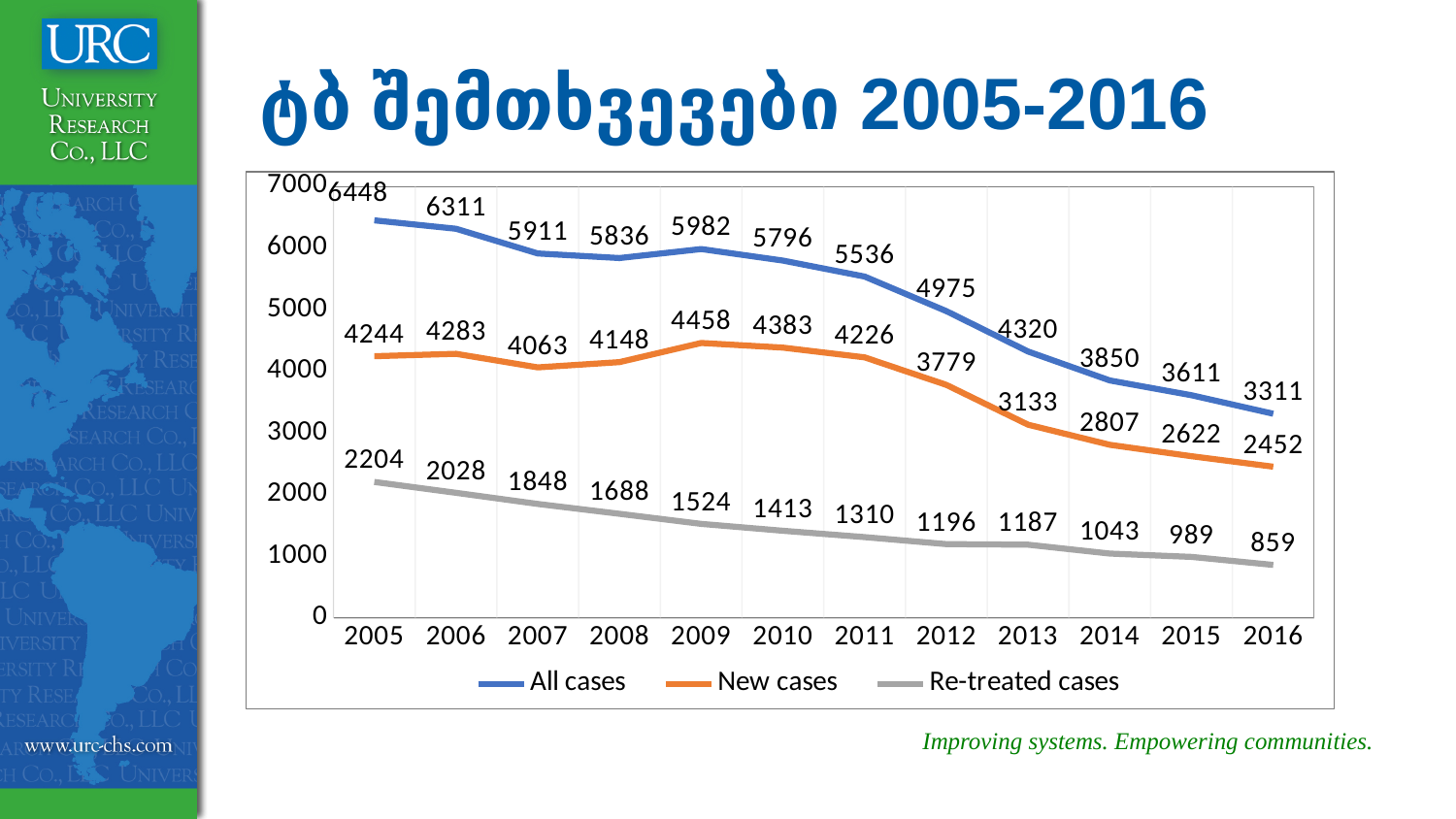
What is the value for New cases in 2009? 4458 In which year is the All cases value lowest? 2016 Which is larger: New cases in 2013 or Re-treated cases in 2005? New cases in 2013 Do the Re-treated cases values rise or fall from 2005 to 2016? Fall What is the value for All cases in 2005? 6448 How many years are shown on the x axis? 12 How many series does the legend list? 3 What is the difference between All cases in 2005 and All cases in 2016? 3137 In which year is the New cases value highest? 2009 What kind of chart is shown on the slide? Line chart What is the value for Re-treated cases in 2016? 859 Which series is drawn in orange? New cases